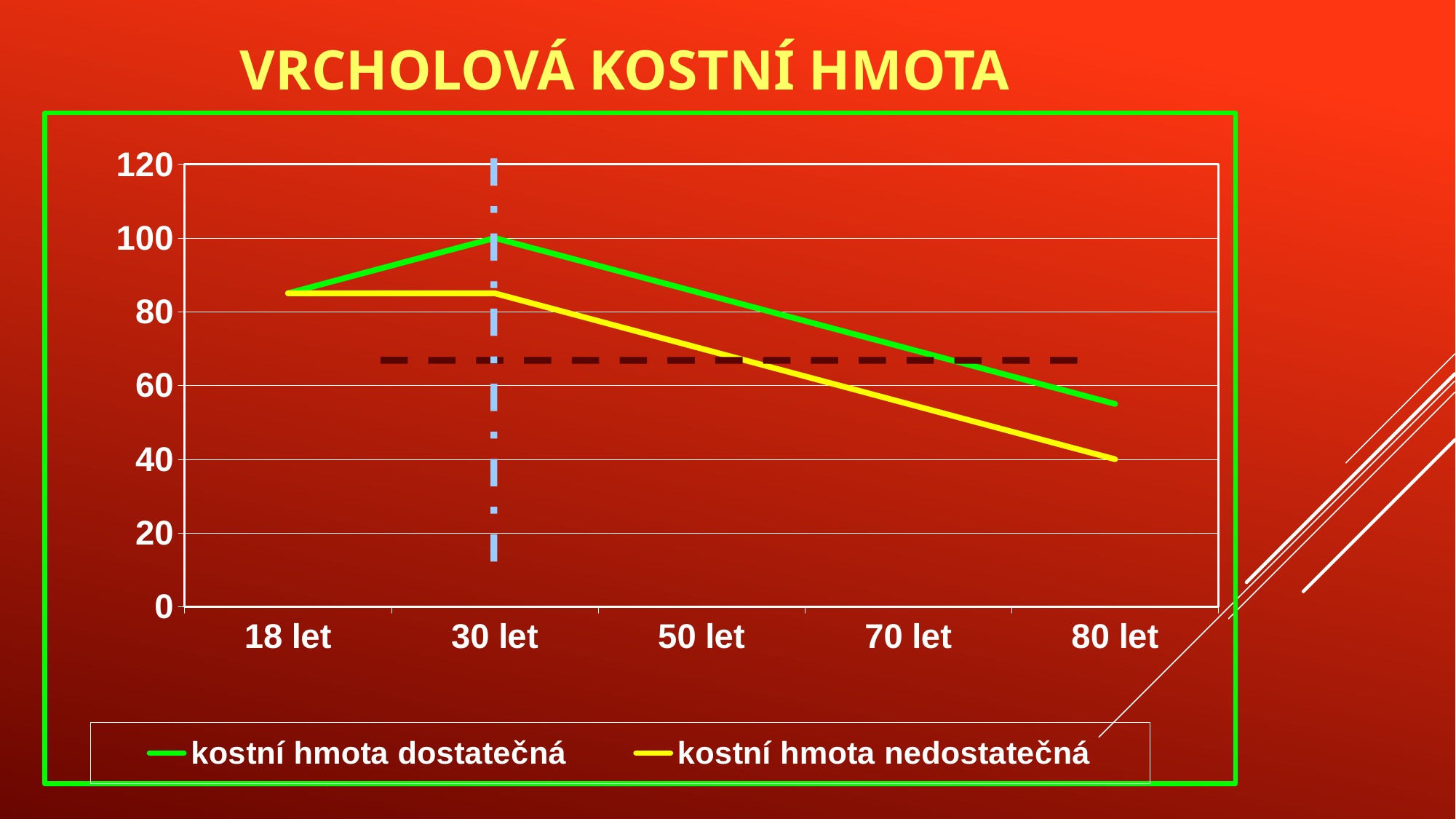
Is the value for 'kostní hmota dostatečná' at 80 let greater or less than 60? less At which age category does 'kostní hmota nedostatečná' reach its lowest value? 80 let What is the value of 'kostní hmota dostatečná' at 30 let? 100 What is the value of 'kostní hmota nedostatečná' at 80 let? 40 How many series does the legend list? 2 At which age category does 'kostní hmota dostatečná' reach its highest value? 30 let What is the title of the slide above the chart? VRCHOLOVÁ KOSTNÍ HMOTA Is the value for 'kostní hmota nedostatečná' at 18 let greater or less than 80? greater How many age categories are shown on the x axis? 5 Do the values of 'kostní hmota nedostatečná' rise or fall from 30 let to 80 let? fall At 70 let, which series has the larger value, 'kostní hmota dostatečná' or 'kostní hmota nedostatečná'? kostní hmota dostatečná What kind of chart is shown on the slide? line chart